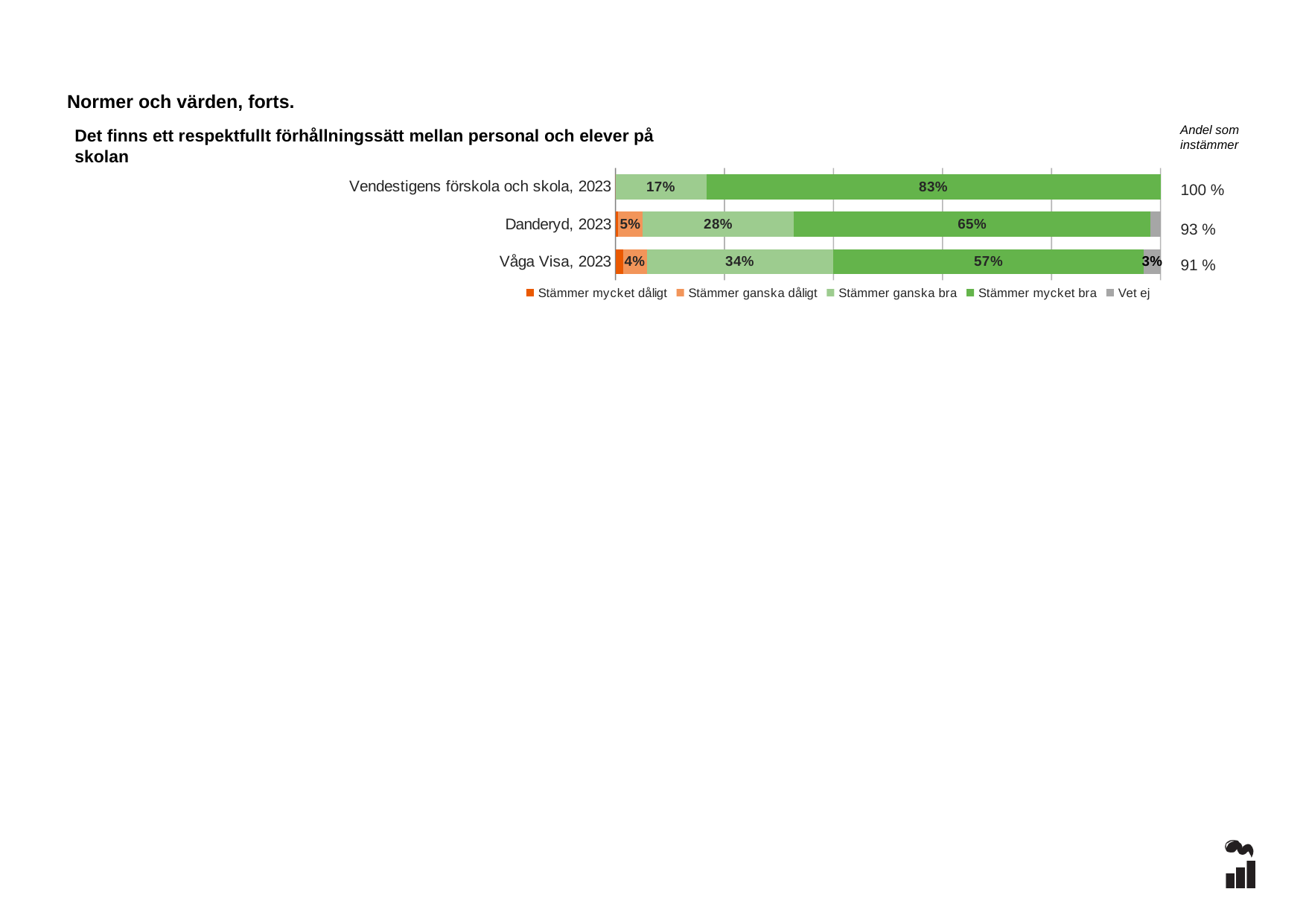
Is the "Stämmer ganska bra" value larger for Danderyd, 2023 or for Våga Visa, 2023? Våga Visa, 2023 Which category has the highest "Stämmer mycket bra" share? Vendestigens förskola och skola, 2023 What is the difference between the "Stämmer mycket bra" values for Vendestigens förskola och skola, 2023 and Danderyd, 2023? 18 percentage points What is the "Stämmer ganska dåligt" value for Danderyd, 2023? 5% What is the "Stämmer ganska bra" value for Våga Visa, 2023? 34% What percentage of respondents at Vendestigens förskola och skola, 2023 answered "Stämmer ganska bra"? 17% What is the "Stämmer mycket bra" value for Danderyd, 2023? 65% What is the "Vet ej" value for Våga Visa, 2023? 3% Which category has the lowest "Stämmer mycket bra" share? Våga Visa, 2023 How many categories (bars) does the chart show? 3 How many series does the legend list? 5 What percentage of respondents at Vendestigens förskola och skola, 2023 answered "Stämmer mycket bra"? 83%